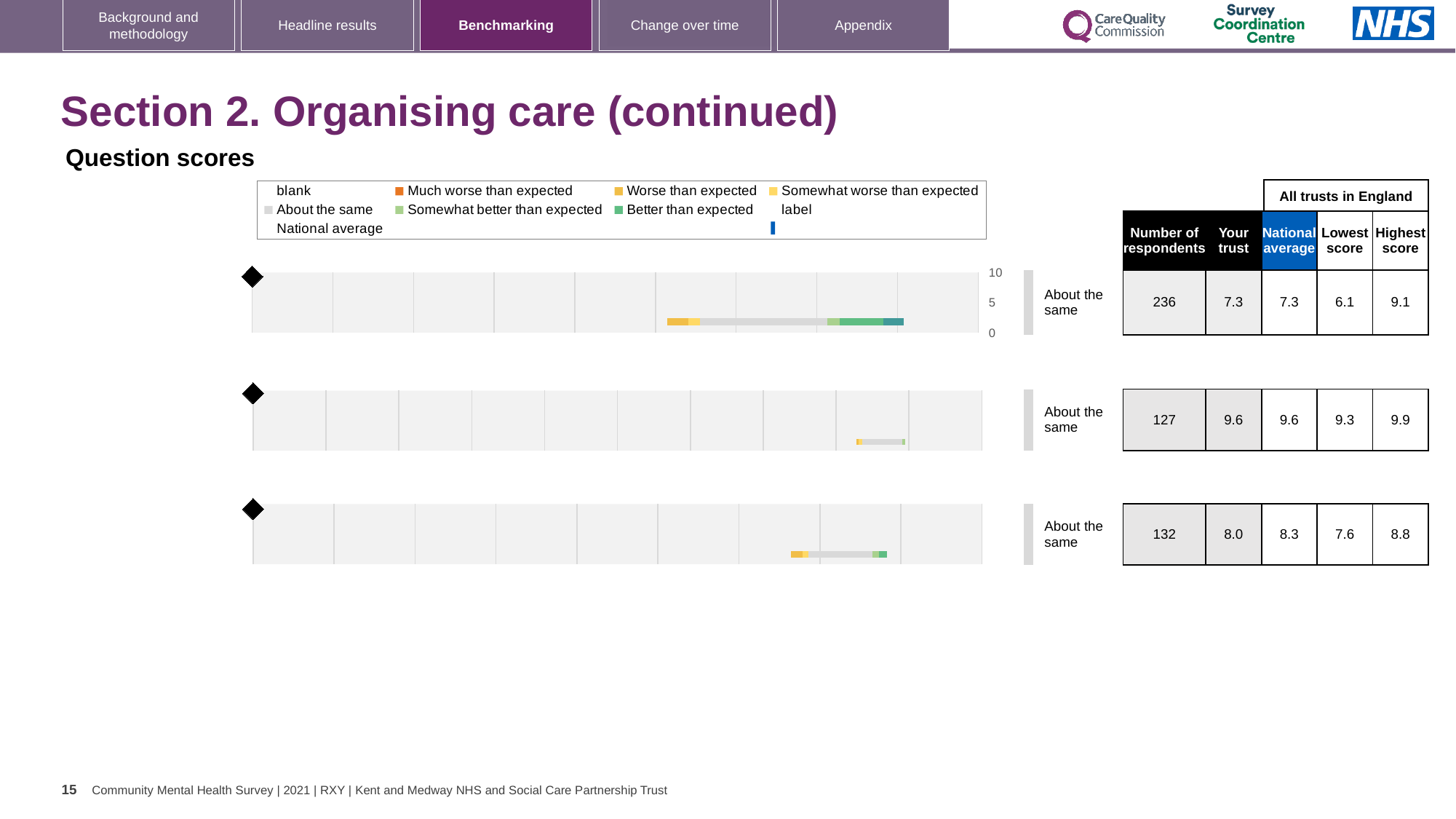
In the bottom chart's row of the table, what is the national average score? 8.3 What benchmark category label is shown next to the bottom chart? About the same In the top chart's row of the table, what is the number of respondents? 236 For the bottom chart's row, is the 'Your trust' score larger or smaller than the national average? Smaller In the top chart's row of the table, what is the lowest score among all trusts in England? 6.1 How many question charts are shown on the slide? 3 In the middle chart's row of the table, what is the 'Your trust' score? 9.6 Which of the three chart rows has the highest 'Your trust' score? The middle row (9.6) In the middle chart's row of the table, what is the highest score among all trusts in England? 9.9 For the top chart's row, what is the difference between the highest score and the lowest score? 3.0 For the bottom chart's row, what is the difference between the national average and the 'Your trust' score? 0.3 What kind of chart is used for each question on the slide? Bar chart